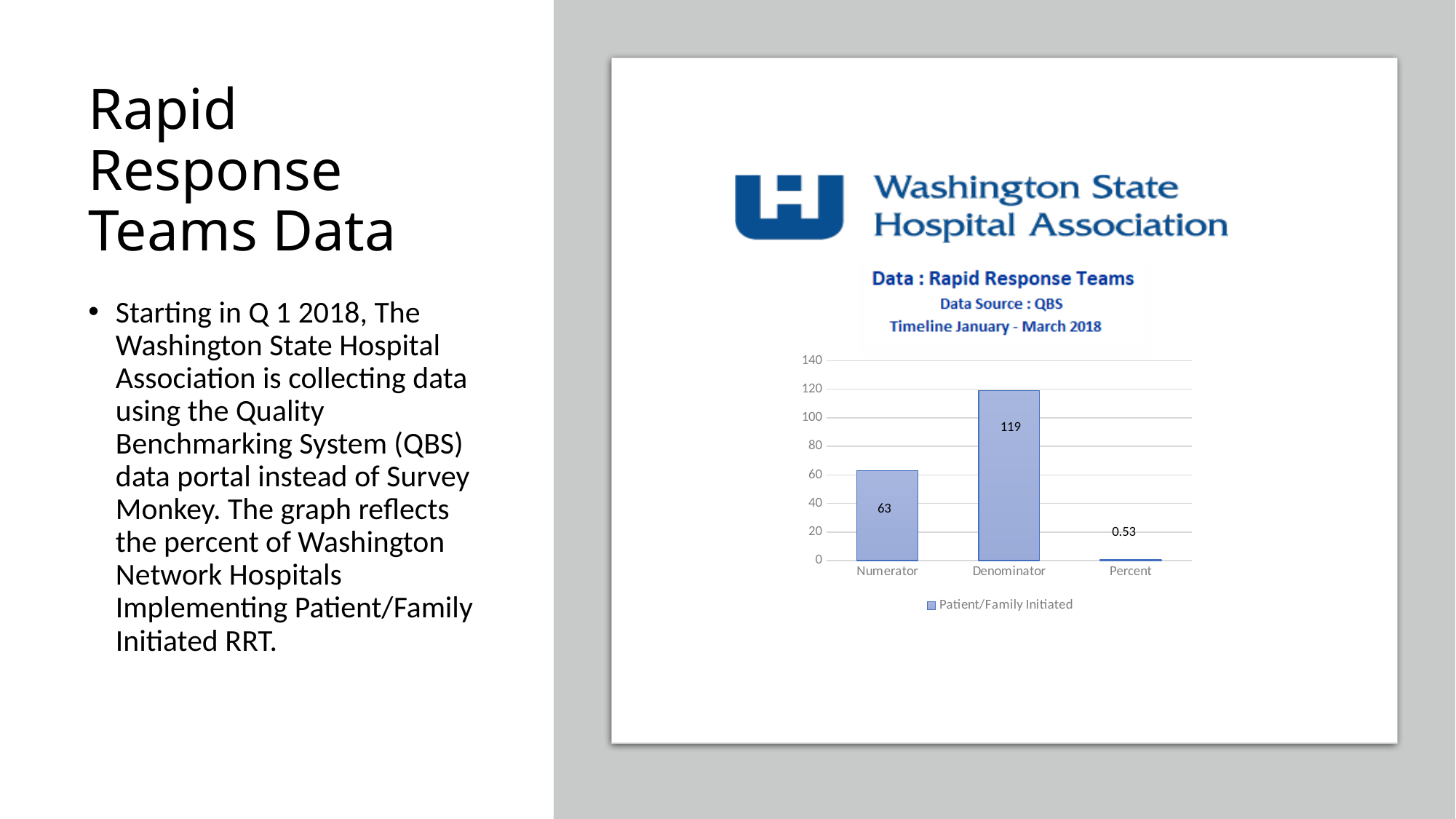
How many categories are shown on the x axis? 3 How many series does the legend list? 1 Which category has the lowest value? Percent What series name is shown in the legend? Patient/Family Initiated Which is larger, the value for Numerator or the value for Denominator? Denominator What kind of chart is shown? bar chart What is the value for Numerator? 63 What is the value for Denominator? 119 What is the value for Percent? 0.53 What is the difference between the Denominator and Numerator values? 56 Which category has the highest value? Denominator Is the value for Denominator greater or less than 100? greater